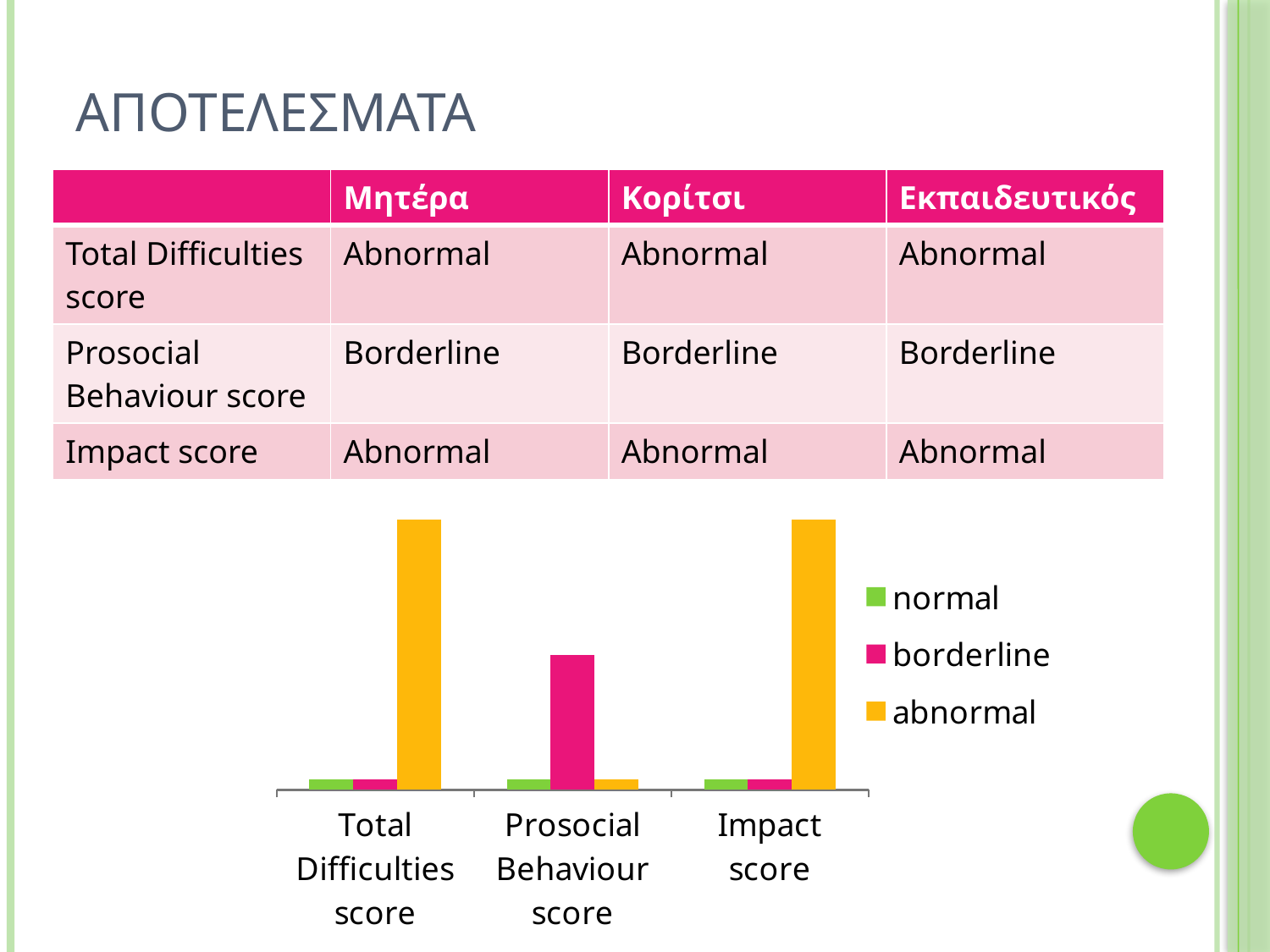
How many series does the chart's legend list? 3 What are the three series listed in the chart's legend? normal, borderline, abnormal What kind of chart is shown on the slide? bar chart For Impact score, is the normal bar or the abnormal bar taller? abnormal What colour represents the abnormal series in the chart? yellow/orange Which series has the tallest bar for Prosocial Behaviour score? borderline Which category has the shortest abnormal bar? Prosocial Behaviour score For Prosocial Behaviour score, is the borderline bar or the abnormal bar taller? borderline How many categories are shown on the x axis of the chart? 3 Which category has the tallest borderline bar? Prosocial Behaviour score Which series has the tallest bar for Impact score? abnormal